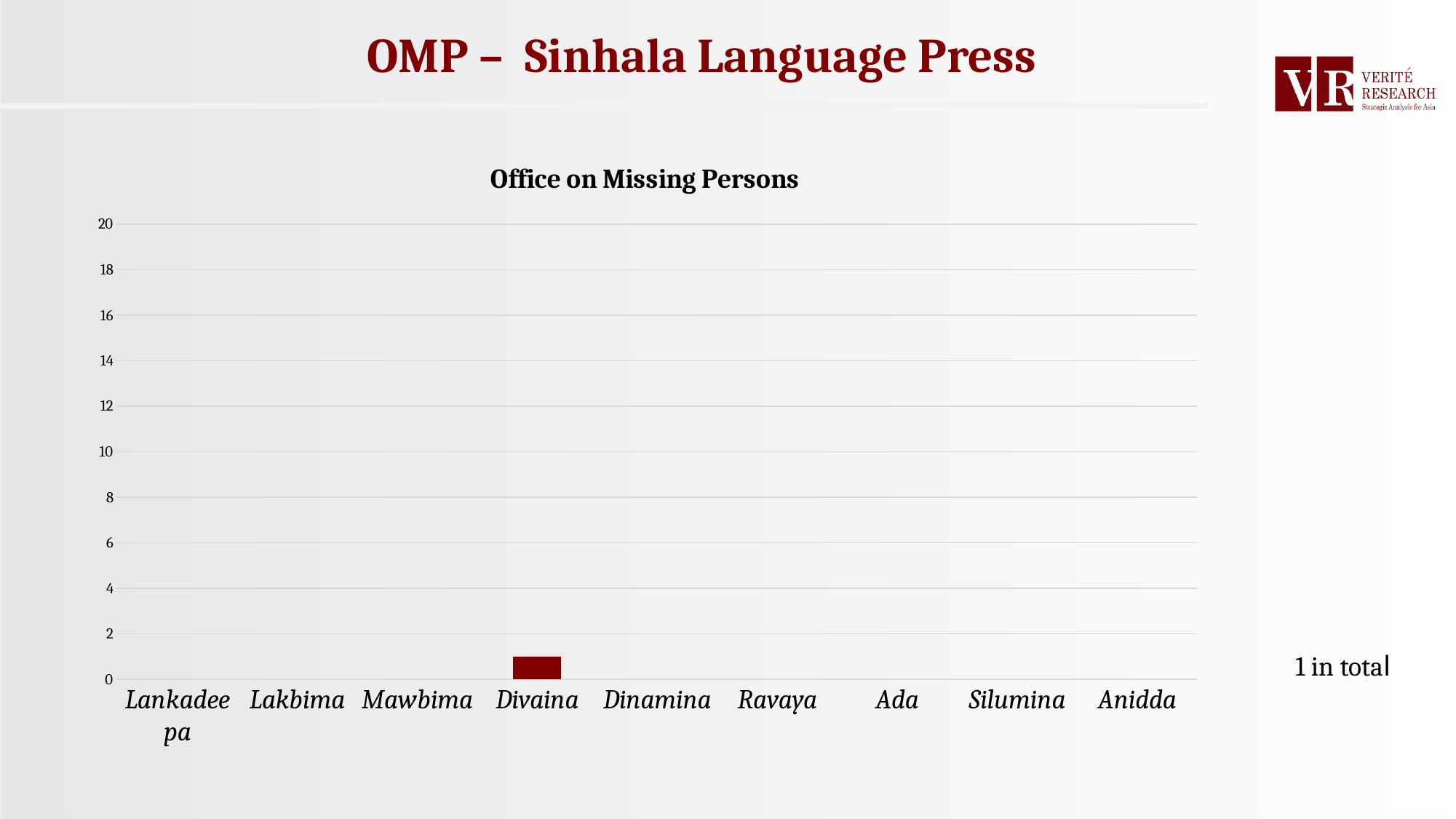
What kind of chart is shown on the slide? bar chart What total is stated in the text to the right of the chart? 1 in total Is the value for Divaina greater or less than 2? less What is the title of the chart? Office on Missing Persons How many newspapers are listed along the x axis of the chart? 9 Which newspaper has the highest value in the chart? Divaina Which has the larger value, Mawbima or Divaina? Divaina Which has the larger value, Divaina or Ravaya? Divaina What is the value for Anidda? 0 Is the value for Divaina greater or less than 10? less What is the value for Lakbima? 0 How many newspapers have a visible bar in the chart? 1